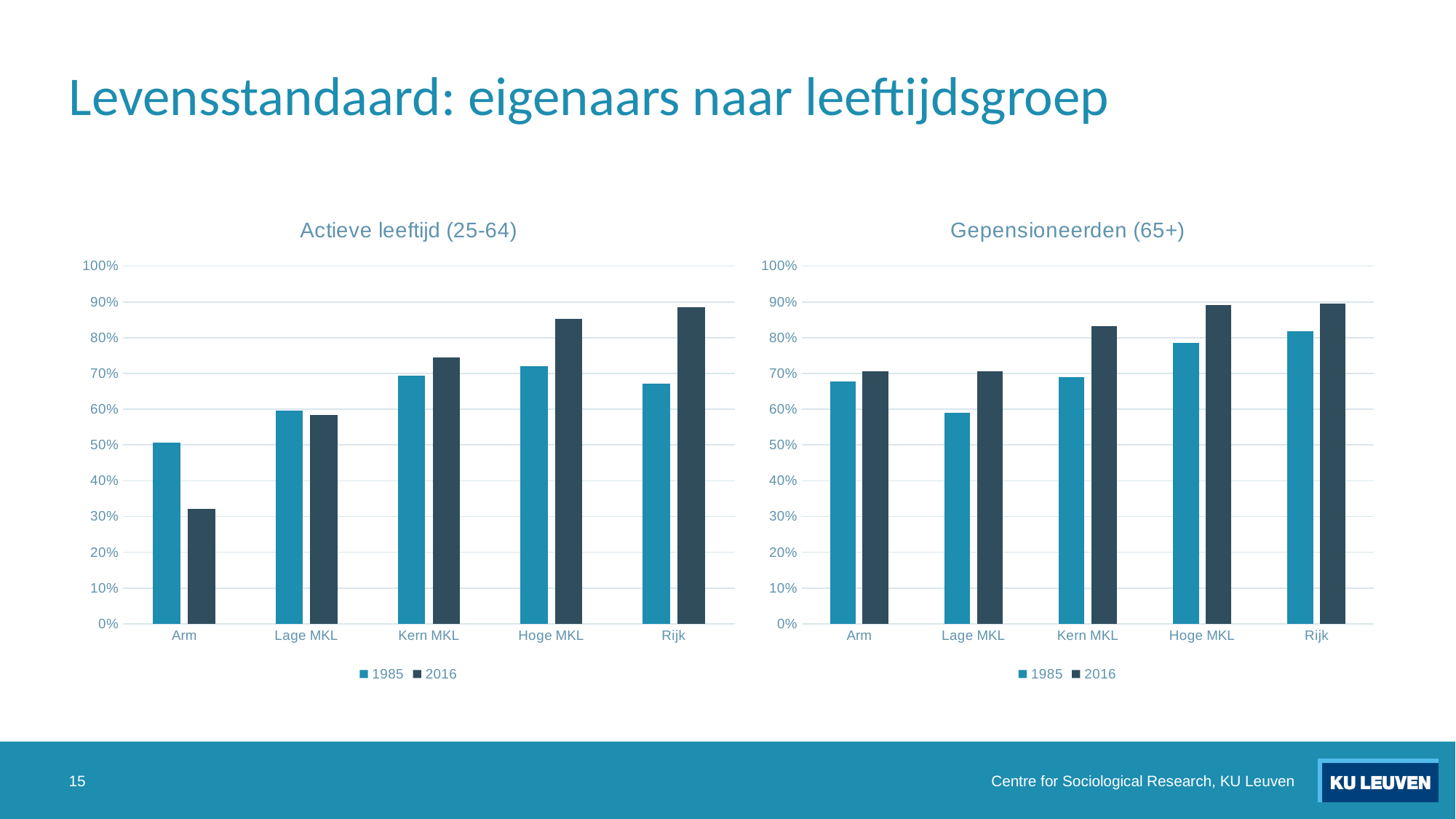
On the 'Actieve leeftijd (25-64)' chart, which is larger for 1985: Hoge MKL or Rijk? Hoge MKL On the 'Gepensioneerden (65+)' chart, which category has the lowest 1985 value? Lage MKL On the 'Actieve leeftijd (25-64)' chart, which category has the lowest 2016 value? Arm On the 'Gepensioneerden (65+)' chart, which category has the highest 1985 value? Rijk How many categories are shown on the x axis of the 'Actieve leeftijd (25-64)' chart? 5 On the 'Actieve leeftijd (25-64)' chart, is the 2016 value for Arm greater or less than 40%? less How many series does the legend of the 'Gepensioneerden (65+)' chart list? 2 On the 'Actieve leeftijd (25-64)' chart, for Arm, which year has the larger value: 1985 or 2016? 1985 On the 'Gepensioneerden (65+)' chart, is the 2016 value for Hoge MKL greater or less than 80%? greater On the 'Actieve leeftijd (25-64)' chart, is the 2016 value for Rijk greater or less than 80%? greater On the 'Actieve leeftijd (25-64)' chart, which category has the highest 2016 value? Rijk